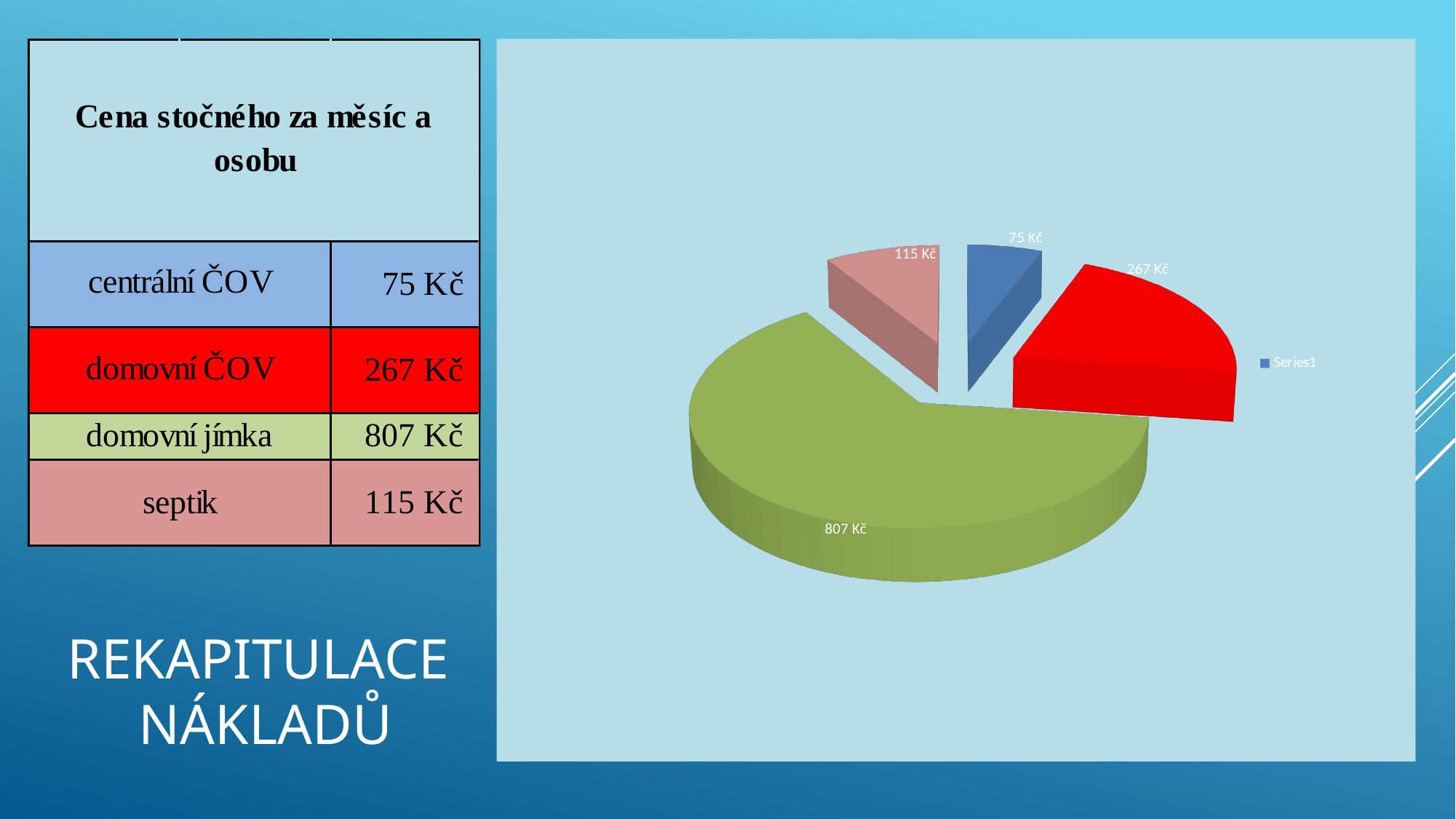
How many slices does the pie chart have? 4 What value is labelled on the green slice of the pie chart? 807 Kč What value is labelled on the blue slice of the pie chart? 75 Kč What kind of chart is shown on the slide? pie chart What value is labelled on the red slice of the pie chart? 267 Kč Which slice of the pie chart has the largest value? 807 Kč (green, domovní jímka) Which slice of the pie chart has the smallest value? 75 Kč (blue, centrální ČOV) What is the name of the series shown in the chart legend? Series1 Which is larger in the pie chart, the pink slice or the blue slice? the pink slice (115 Kč) What is the difference between the red slice (267 Kč) and the pink slice (115 Kč) in the pie chart? 152 Kč How many series does the chart legend list? 1 What value is labelled on the pink slice of the pie chart? 115 Kč